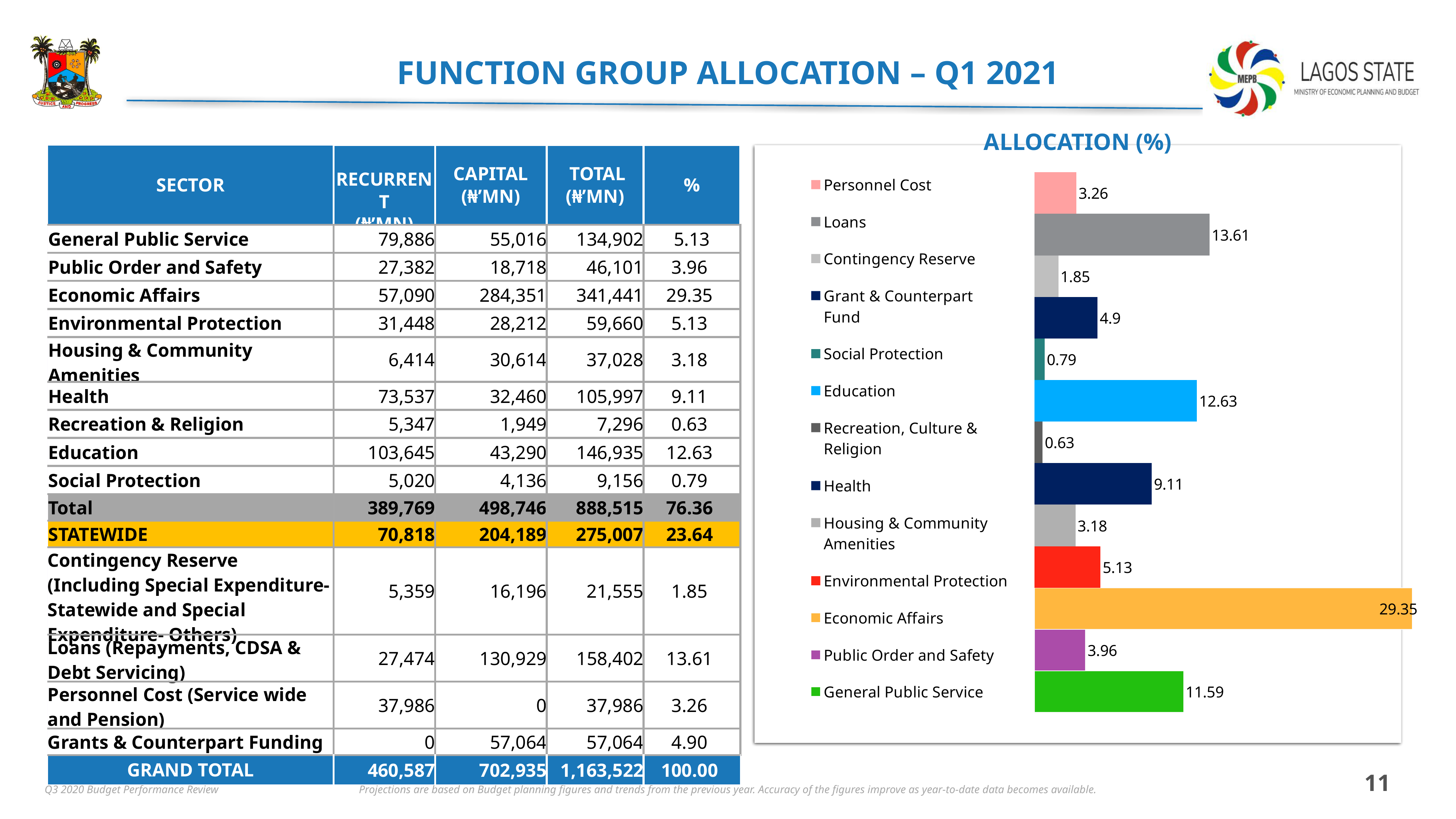
What is the value for Economic Affairs in the chart? 29.35 What is the value for General Public Service in the chart? 11.59 What is the value for Social Protection in the chart? 0.79 What is the value for Loans in the chart? 13.61 How many categories are plotted in the chart? 13 Which category has the highest value in the chart? Economic Affairs How many entries does the chart's legend list? 13 What is the title of the chart? ALLOCATION (%) What is the difference between the values for Loans and Education in the chart? 0.98 What kind of chart is shown on the slide? bar chart Which category has the lowest value in the chart? Recreation, Culture & Religion Which is larger in the chart, Health or Environmental Protection? Health